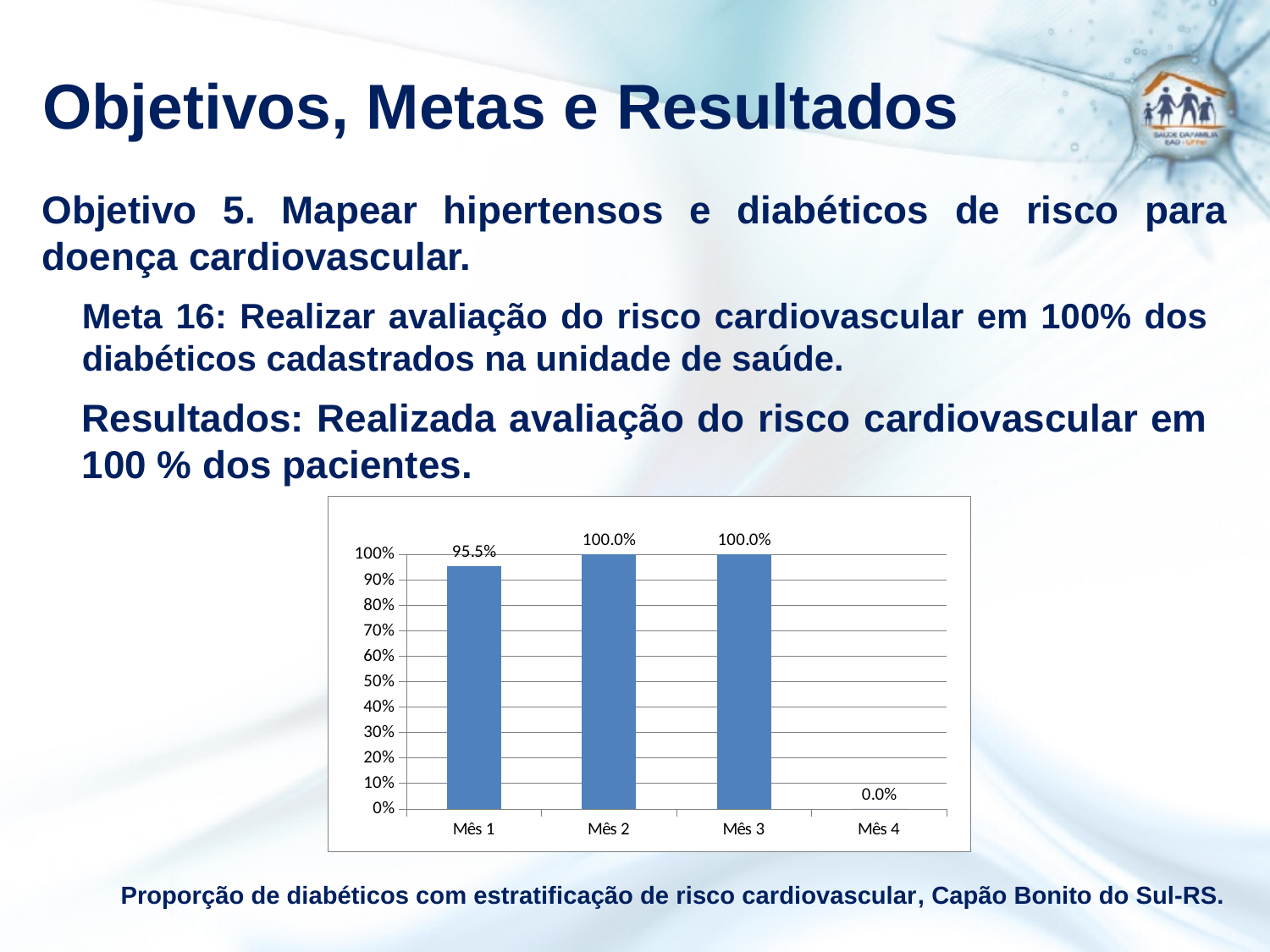
What kind of chart is shown on the slide? bar chart What is the value for Mês 2? 100.0% Do the values rise or fall from Mês 1 to Mês 2? rise What is the difference between the values for Mês 2 and Mês 1? 4.5% Is the value for Mês 1 greater or less than 90%? greater Which category has the lowest value? Mês 4 What is the highest tick value shown on the y axis? 100% What is the value for Mês 1? 95.5% What is the value for Mês 4? 0.0% How many categories are shown on the x axis? 4 What is the caption printed below the chart? Proporção de diabéticos com estratificação de risco cardiovascular, Capão Bonito do Sul-RS. Which is larger, the value for Mês 1 or the value for Mês 3? Mês 3